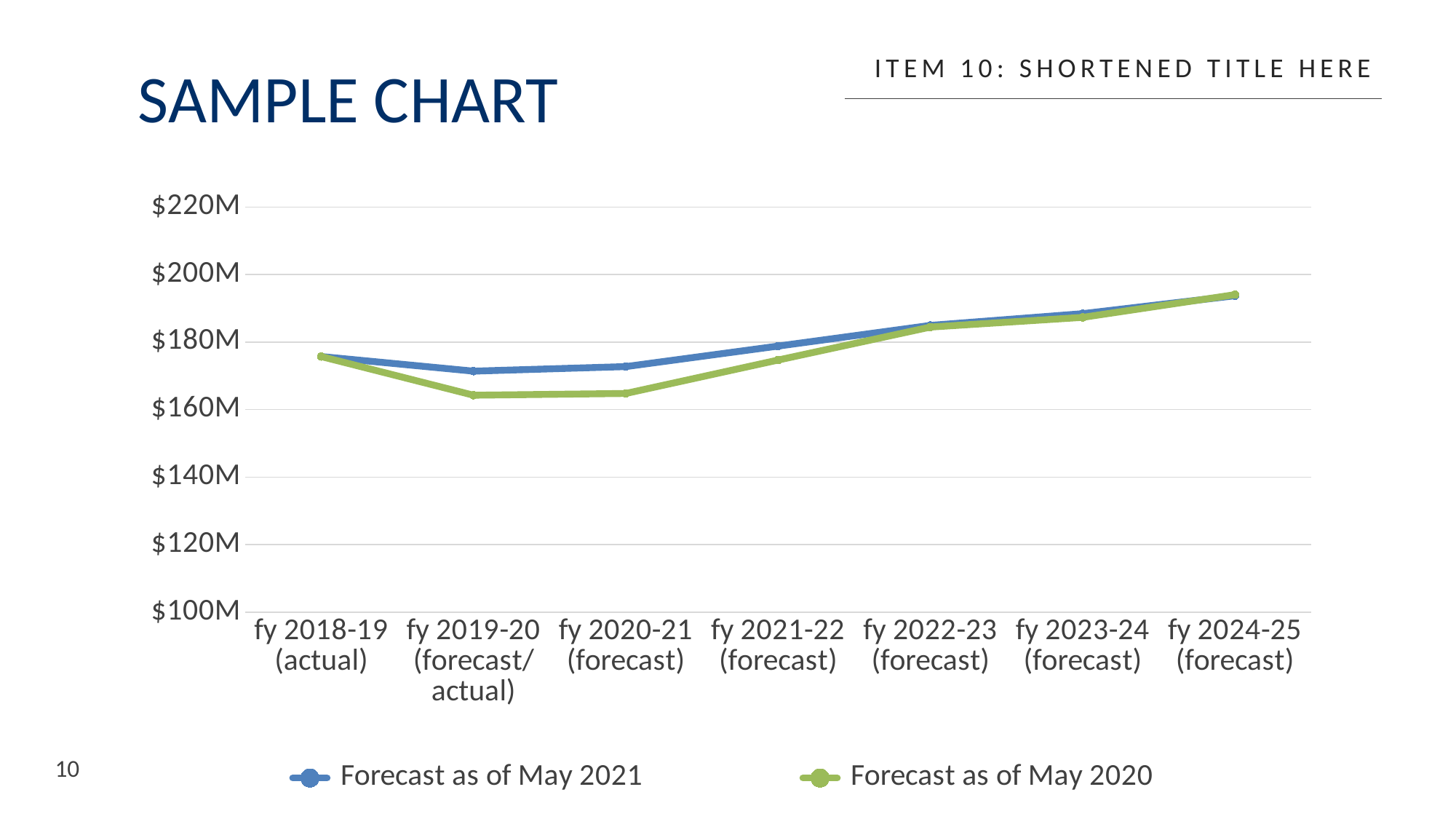
Is the value for Forecast as of May 2021 in fy 2024-25 greater or less than $200M? less In which fiscal year does the Forecast as of May 2020 series reach its highest value? fy 2024-25 (forecast) What is the title of the chart? SAMPLE CHART Is the value for Forecast as of May 2020 in fy 2024-25 greater or less than $180M? greater Is the value for Forecast as of May 2020 in fy 2020-21 greater or less than $160M? greater Do the values for Forecast as of May 2021 rise or fall from fy 2020-21 to fy 2024-25? rise How many series does the legend list? 2 What kind of chart is shown on the slide? Line chart How many fiscal years are plotted along the x axis? 7 In fy 2020-21, which series has the higher value? Forecast as of May 2021 In fy 2019-20, which series has the higher value? Forecast as of May 2021